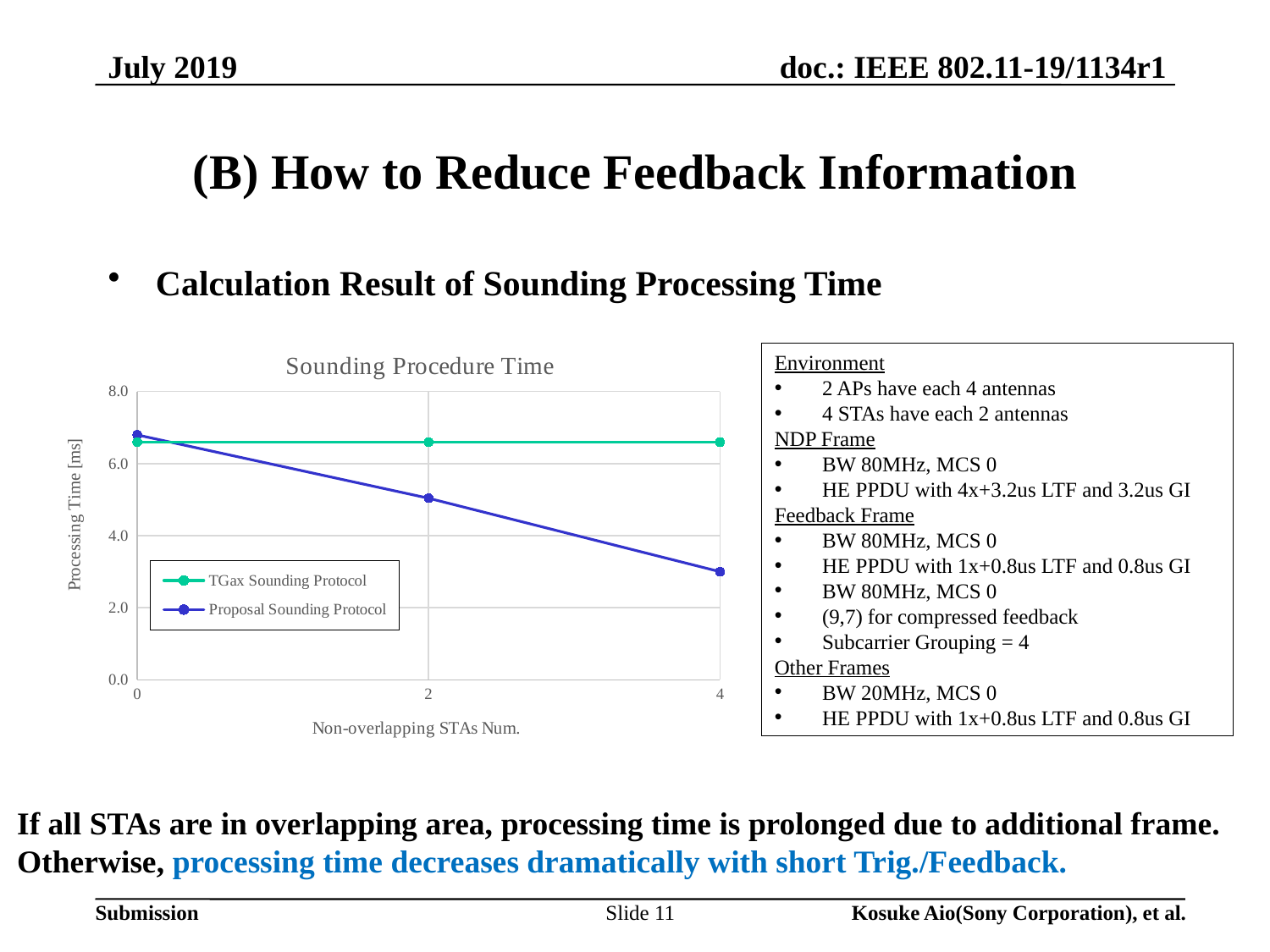
Does the TGax Sounding Protocol processing time change noticeably as the number of non-overlapping STAs increases? No, it stays flat Does the Proposal Sounding Protocol processing time rise or fall as the number of non-overlapping STAs increases? fall How many data points are plotted for the Proposal Sounding Protocol series? 3 How many series does the chart's legend list? 2 What is the label of the x axis of the chart? Non-overlapping STAs Num. What kind of chart is shown on the slide? line chart Is the Proposal Sounding Protocol processing time at 2 non-overlapping STAs greater or less than 6.0 ms? less What is the title of the chart? Sounding Procedure Time Is the Proposal Sounding Protocol processing time at 4 non-overlapping STAs greater or less than 4.0 ms? less At 2 non-overlapping STAs, which series has the larger processing time, TGax Sounding Protocol or Proposal Sounding Protocol? TGax Sounding Protocol Is the TGax Sounding Protocol processing time at 0 non-overlapping STAs greater or less than 6.0 ms? greater At 4 non-overlapping STAs, which series has the larger processing time, TGax Sounding Protocol or Proposal Sounding Protocol? TGax Sounding Protocol